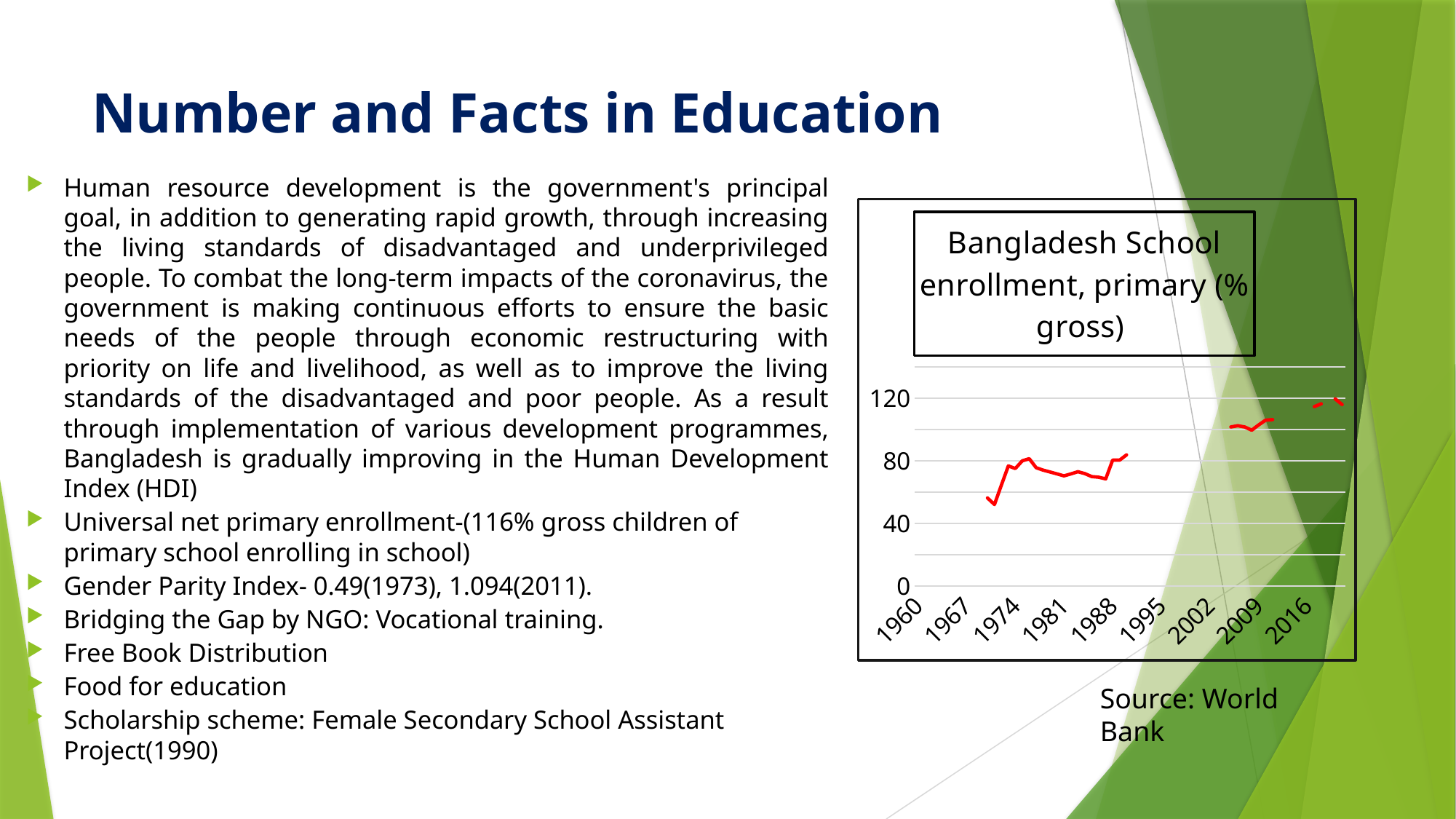
What kind of chart is shown on the slide? line chart How many year labels are shown on the x axis of the chart? 9 What is the first year label on the x axis? 1960 Which year has the larger value, 1981 or 2009? 2009 Is the value for 1974 greater or less than 120? less What is the highest tick value shown on the y axis? 120 What is the title of the chart? Bangladesh School enrollment, primary (% gross) Is the value for 1981 greater or less than 40? greater Is the value for 2009 greater or less than 80? greater Overall, do the plotted values rise or fall from the 1970s to 2016? rise What source is cited below the chart? World Bank